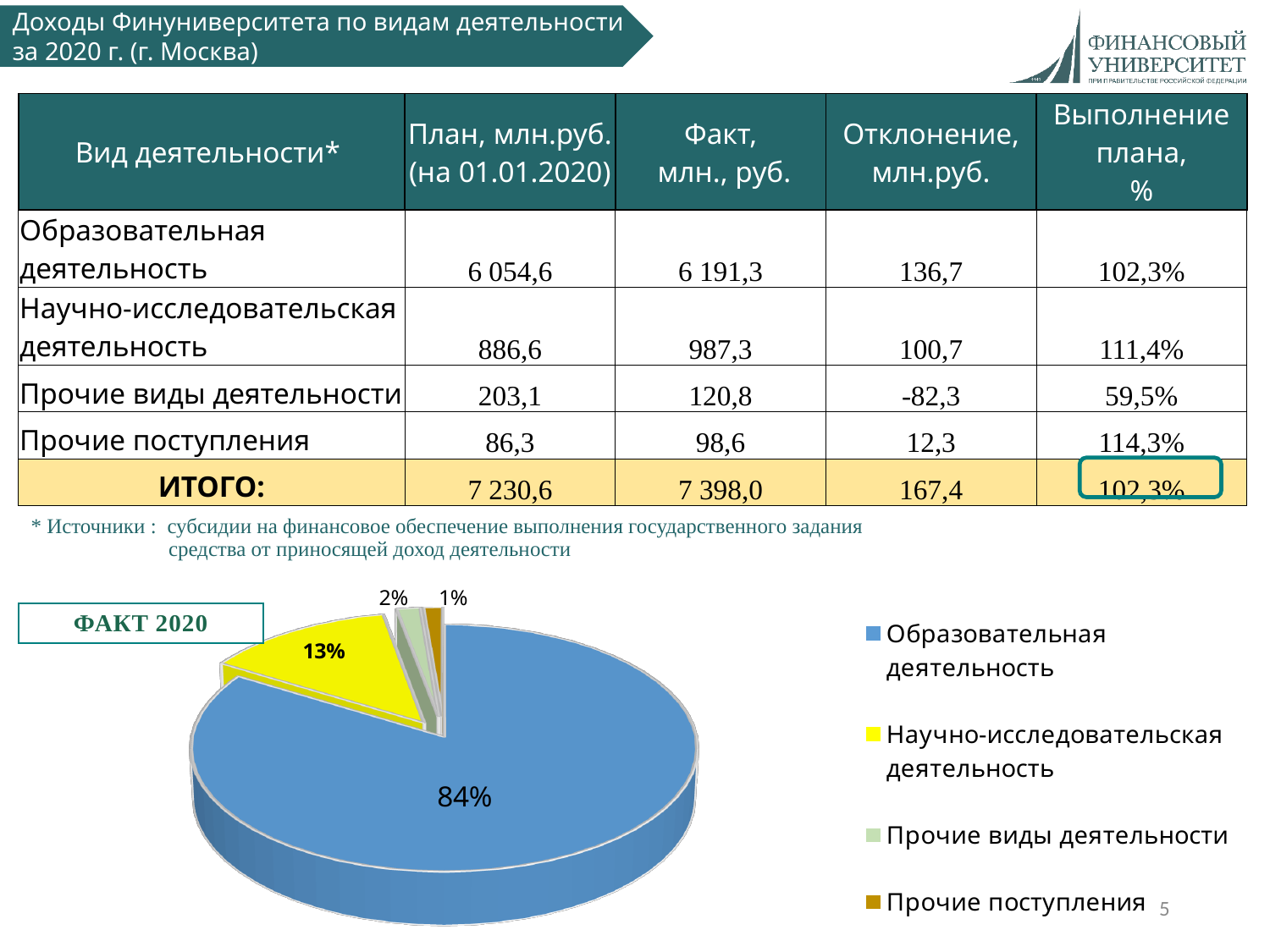
What is the difference in percentage points between the slices for Образовательная деятельность and Научно-исследовательская деятельность? 71 percentage points What share of the pie does Образовательная деятельность have? 84% What share of the pie does Научно-исследовательская деятельность have? 13% Which category has the smallest slice of the pie? Прочие поступления How many entries does the chart legend list? 4 Which category has the largest slice of the pie? Образовательная деятельность Which slice is larger: Научно-исследовательская деятельность or Прочие виды деятельности? Научно-исследовательская деятельность What kind of chart is shown on the slide? Pie chart What share of the pie does Прочие виды деятельности have? 2% What colour is the slice for Научно-исследовательская деятельность? Yellow What share of the pie does Прочие поступления have? 1% How many slices does the pie chart have? 4